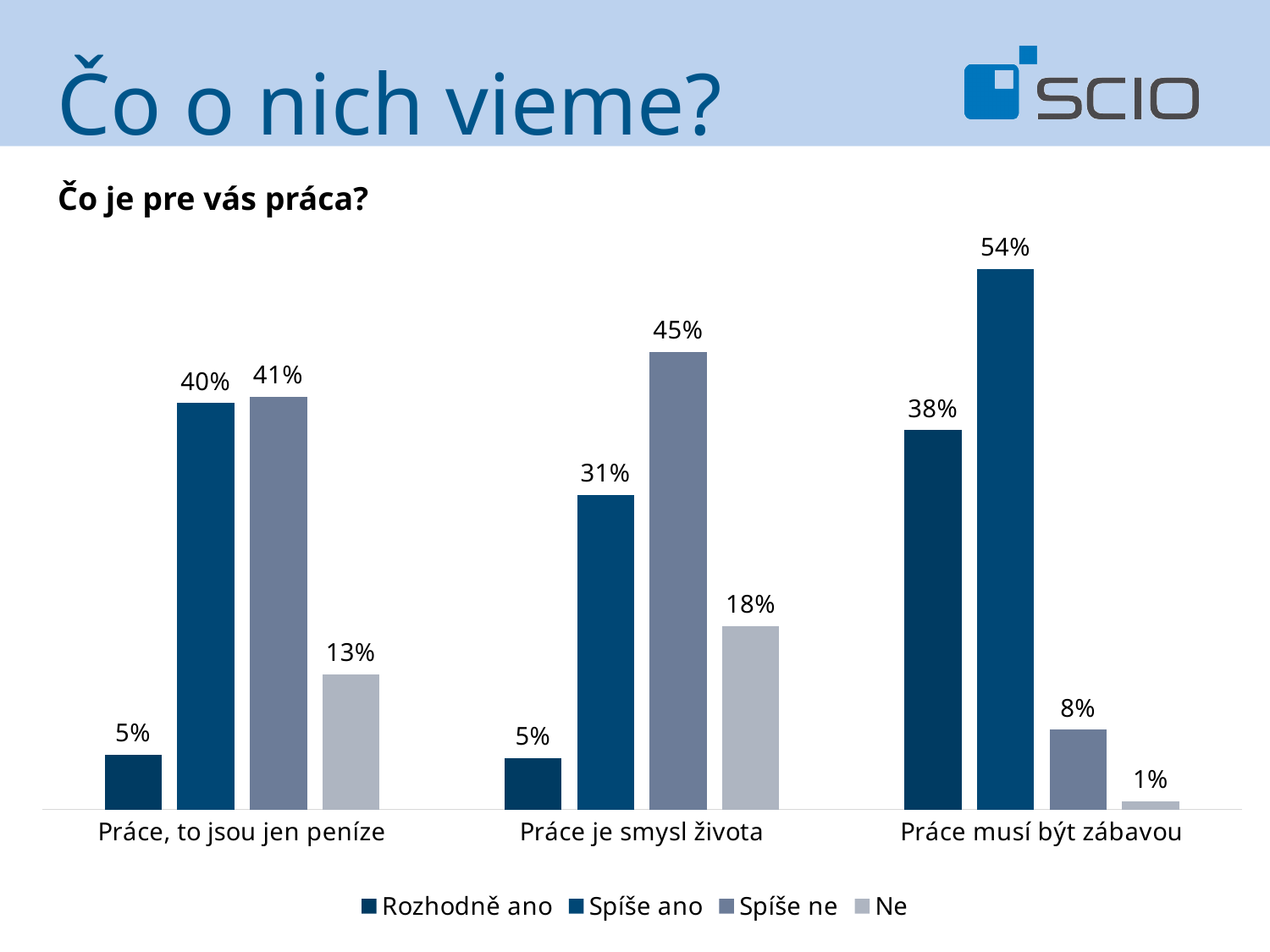
Which is larger: "Spíše ano" for "Práce, to jsou jen peníze" or "Spíše ano" for "Práce je smysl života"? Práce, to jsou jen peníze What is the title of the chart? Čo je pre vás práca? What is the value for "Spíše ne" in the "Práce je smysl života" category? 45% What is the value for "Ne" in the "Práce musí být zábavou" category? 1% How many series does the legend list? 4 How many categories are shown on the x axis? 3 What is the difference between "Spíše ano" and "Spíše ne" in the "Práce musí být zábavou" category? 46% What is the value for "Rozhodně ano" in the "Práce musí být zábavou" category? 38% Which series has the highest value in the "Práce musí být zábavou" category? Spíše ano What kind of chart is shown on the slide? Bar chart What is the value for "Ne" in the "Práce, to jsou jen peníze" category? 13% Which series has the lowest value in the "Práce je smysl života" category? Rozhodně ano